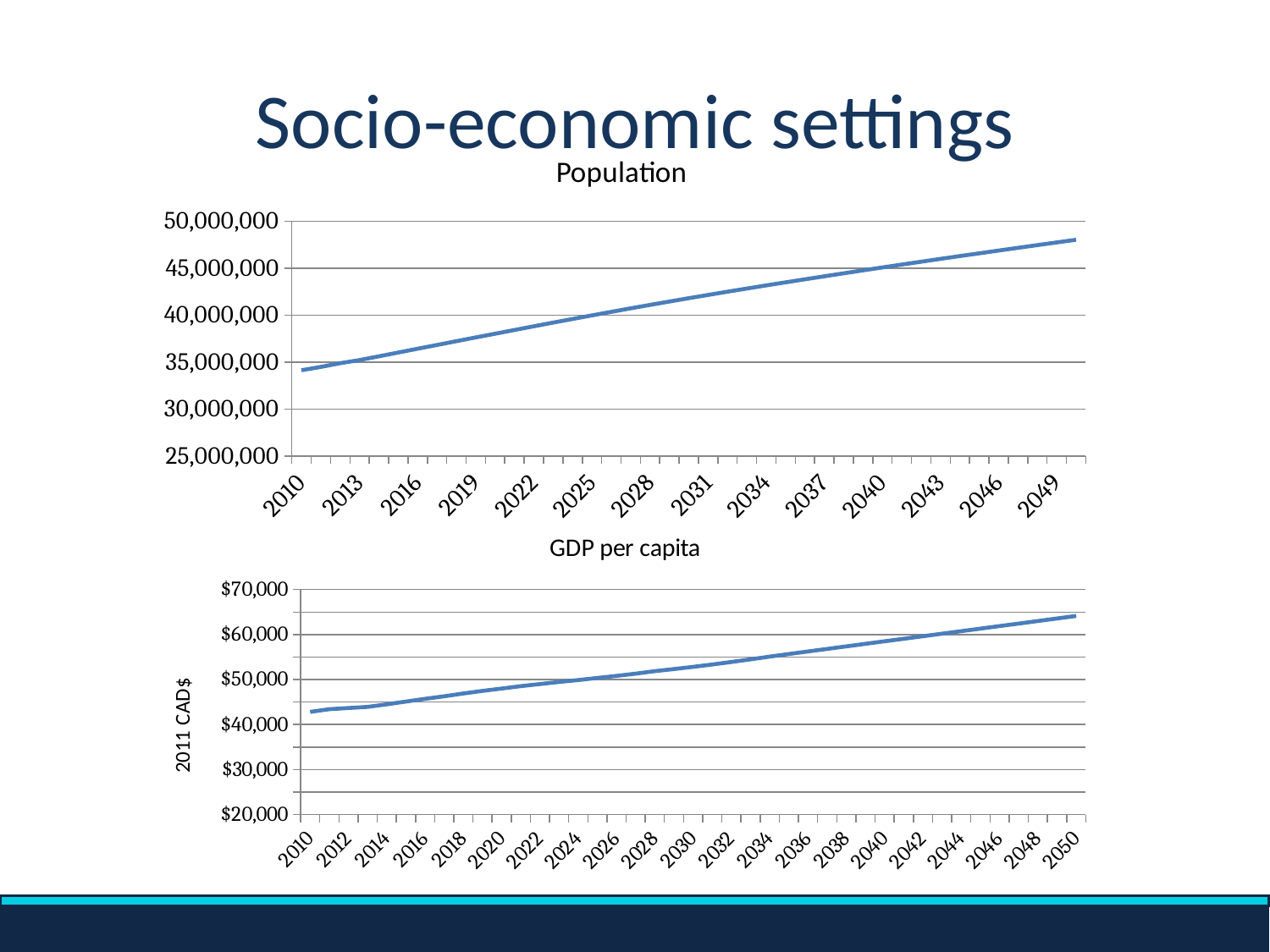
In the Population chart, is the value for 2049 greater or less than 45,000,000? greater What kind of chart is the Population chart? line chart In the Population chart, does the value rise or fall from 2010 to 2049? rise In the GDP per capita chart, is the value for 2050 greater or less than $70,000? less In the GDP per capita chart, does the value rise or fall from 2010 to 2050? rise What kind of chart is the GDP per capita chart? line chart In the Population chart, is the value for 2010 greater or less than 35,000,000? less What is the y-axis label of the GDP per capita chart? 2011 CAD$ In the Population chart, which year has the lowest value? 2010